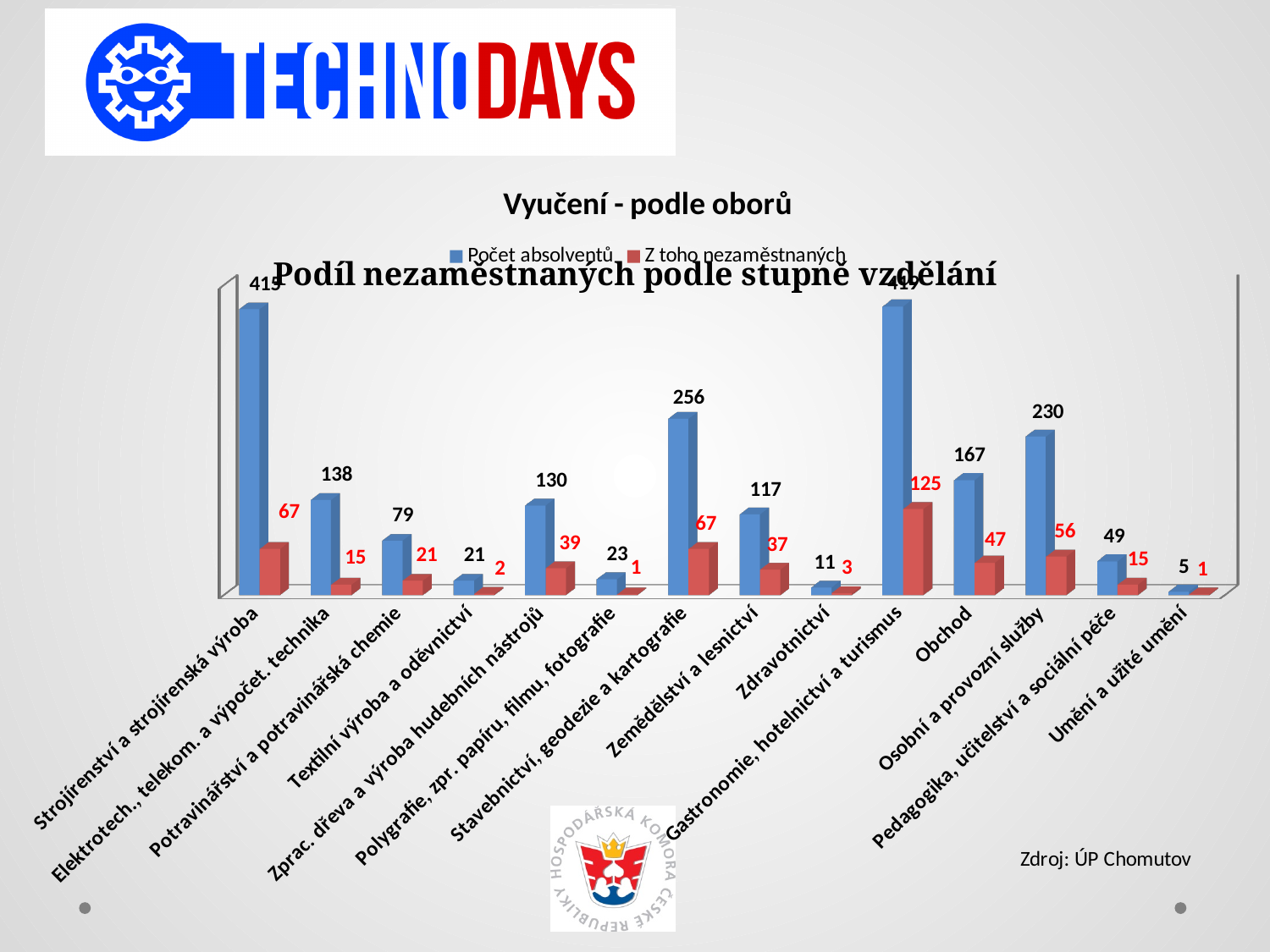
What is the value of Z toho nezaměstnaných for Gastronomie, hotelnictví a turismus? 125 Which category has the highest value of Z toho nezaměstnaných? Gastronomie, hotelnictví a turismus Which has a higher Počet absolventů: Elektrotech., telekom. a výpočet. technika or Zemědělství a lesnictví? Elektrotech., telekom. a výpočet. technika What is the difference between Počet absolventů and Z toho nezaměstnaných for Osobní a provozní služby? 174 What is the value of Počet absolventů for Stavebnictví, geodezie a kartografie? 256 What is the title of the chart? Vyučení - podle oborů Which category has the lowest value of Počet absolventů? Umění a užité umění What is the value of Z toho nezaměstnaných for Zprac. dřeva a výroba hudebních nástrojů? 39 How many categories (fields) are shown on the x axis? 14 How many series does the legend list? 2 What type of chart is shown on the slide? bar chart What is the value of Počet absolventů for Obchod? 167